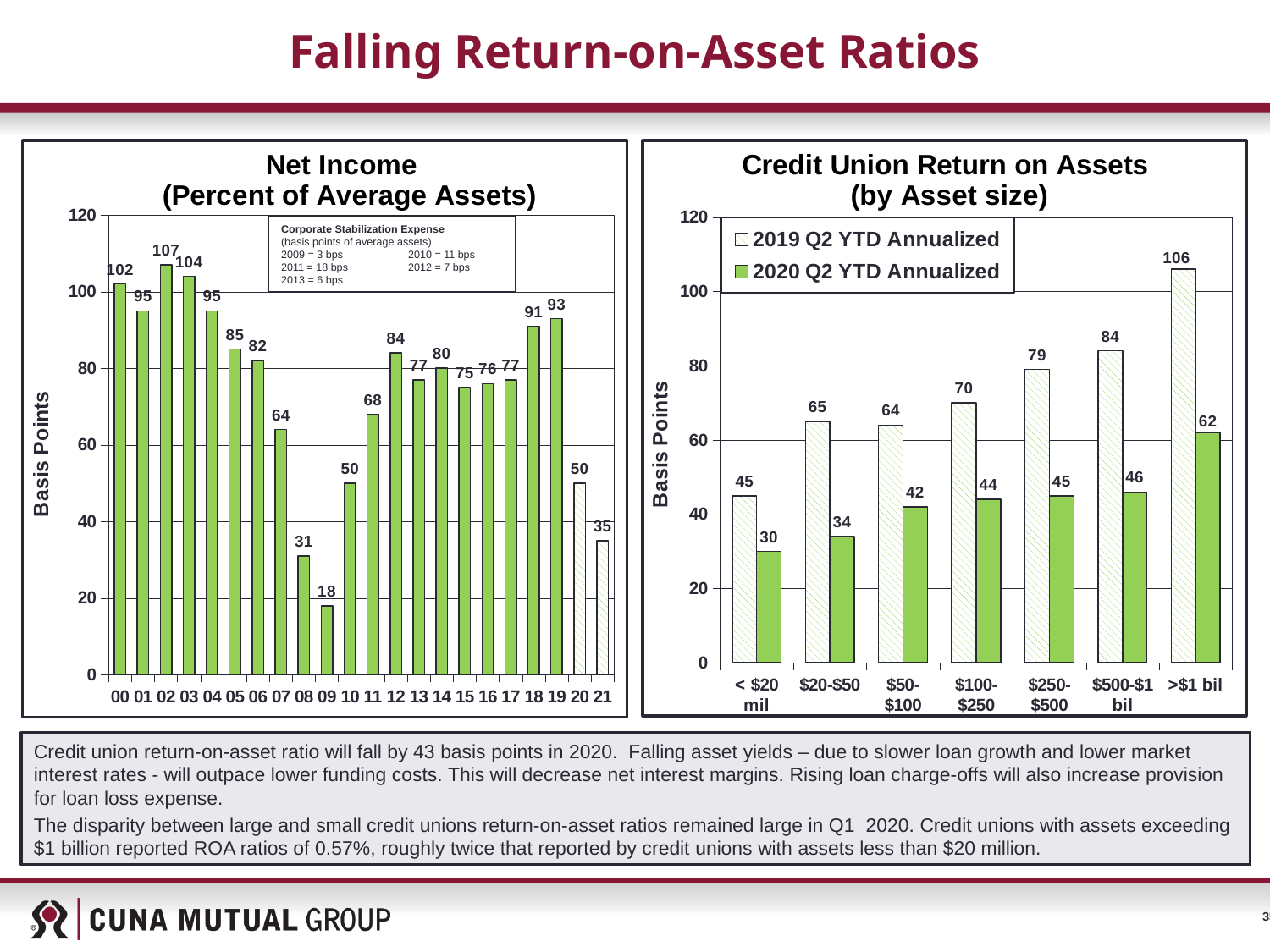
In the Net Income (Percent of Average Assets) chart, what is the value for 2009 (09)? 18 In the Credit Union Return on Assets (by Asset size) chart, how many series does the legend list? 2 In the Net Income (Percent of Average Assets) chart, how many years are shown on the x axis? 22 In the Credit Union Return on Assets (by Asset size) chart, what is the difference between the 2019 and 2020 values for the $500-$1 bil category? 38 What kind of chart is the Credit Union Return on Assets (by Asset size) chart? Bar chart In the Credit Union Return on Assets (by Asset size) chart, which is larger: the 2019 value for $20-$50 or the 2019 value for $50-$100? $20-$50 In the Net Income (Percent of Average Assets) chart, what is the difference between the values for 19 and 20? 43 In the Net Income (Percent of Average Assets) chart, what is the value for 2021 (21)? 35 In the Net Income (Percent of Average Assets) chart, which year has the highest value? 02 In the Credit Union Return on Assets (by Asset size) chart, what is the 2020 Q2 YTD Annualized value for the >$1 bil category? 62 In the Net Income (Percent of Average Assets) chart, which year has the lowest value? 09 In the Credit Union Return on Assets (by Asset size) chart, which asset size category has the highest 2019 Q2 YTD Annualized value? >$1 bil